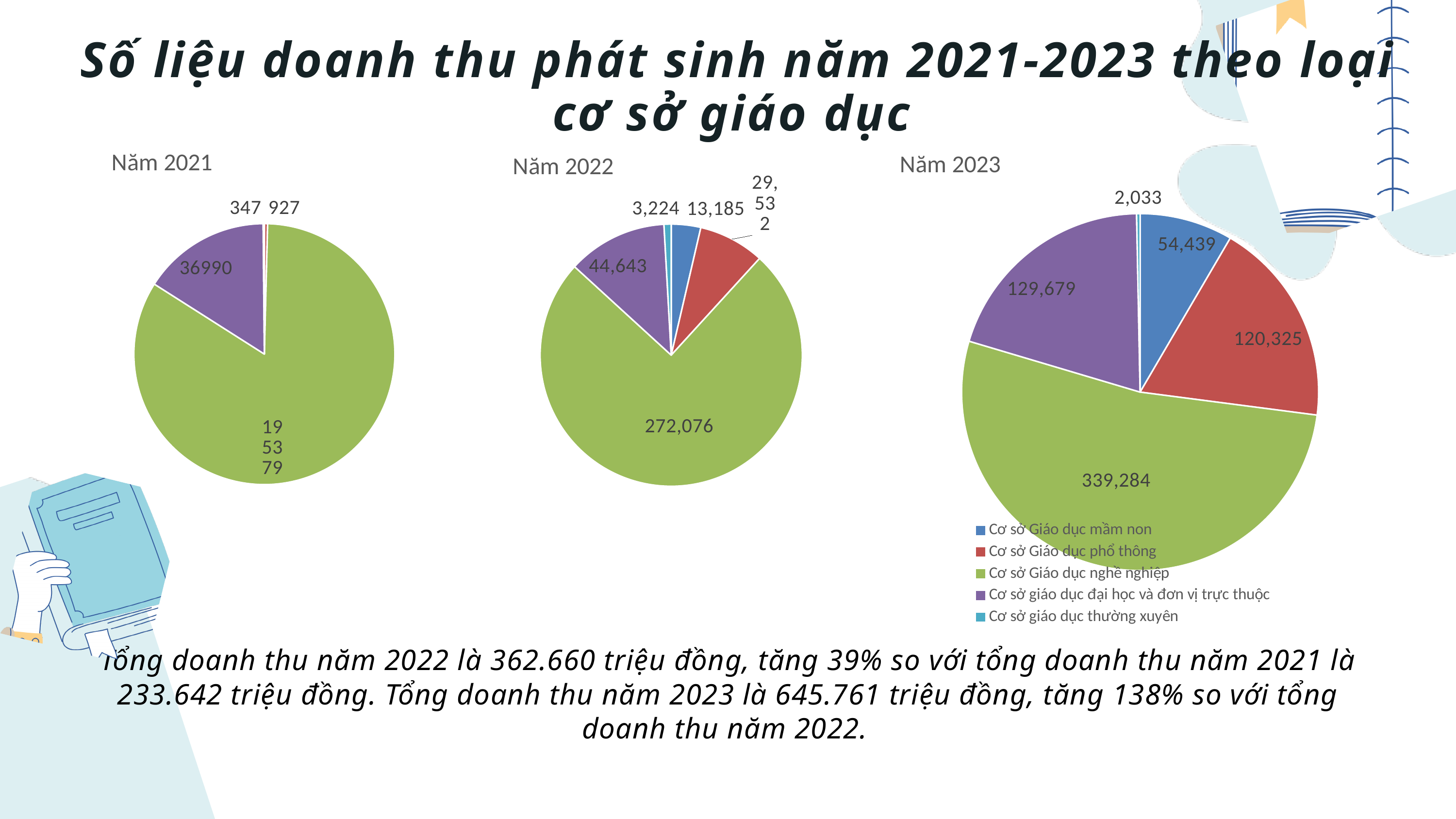
In the Năm 2023 chart, what is the value for Cơ sở Giáo dục nghề nghiệp? 339,284 In the Năm 2023 chart, which category has the largest slice? Cơ sở Giáo dục nghề nghiệp What kind of chart is used for each year on the slide? Pie chart In the Năm 2023 chart, what is the value for Cơ sở giáo dục thường xuyên? 2,033 In the Năm 2022 chart, what is the value for Cơ sở giáo dục đại học và đơn vị trực thuộc? 44,643 In the Năm 2022 chart, what is the value for Cơ sở Giáo dục nghề nghiệp? 272,076 In the Năm 2021 chart, what is the value for Cơ sở giáo dục đại học và đơn vị trực thuộc? 36990 How many series does the legend list? 5 In the Năm 2022 chart, which category has the smallest slice? Cơ sở giáo dục thường xuyên In the Năm 2023 chart, what is the difference between the values for Cơ sở giáo dục đại học và đơn vị trực thuộc and Cơ sở Giáo dục phổ thông? 9,354 In the Năm 2023 chart, what is the value for Cơ sở Giáo dục mầm non? 54,439 In the Năm 2022 chart, which is larger: Cơ sở Giáo dục phổ thông or Cơ sở Giáo dục mầm non? Cơ sở Giáo dục phổ thông